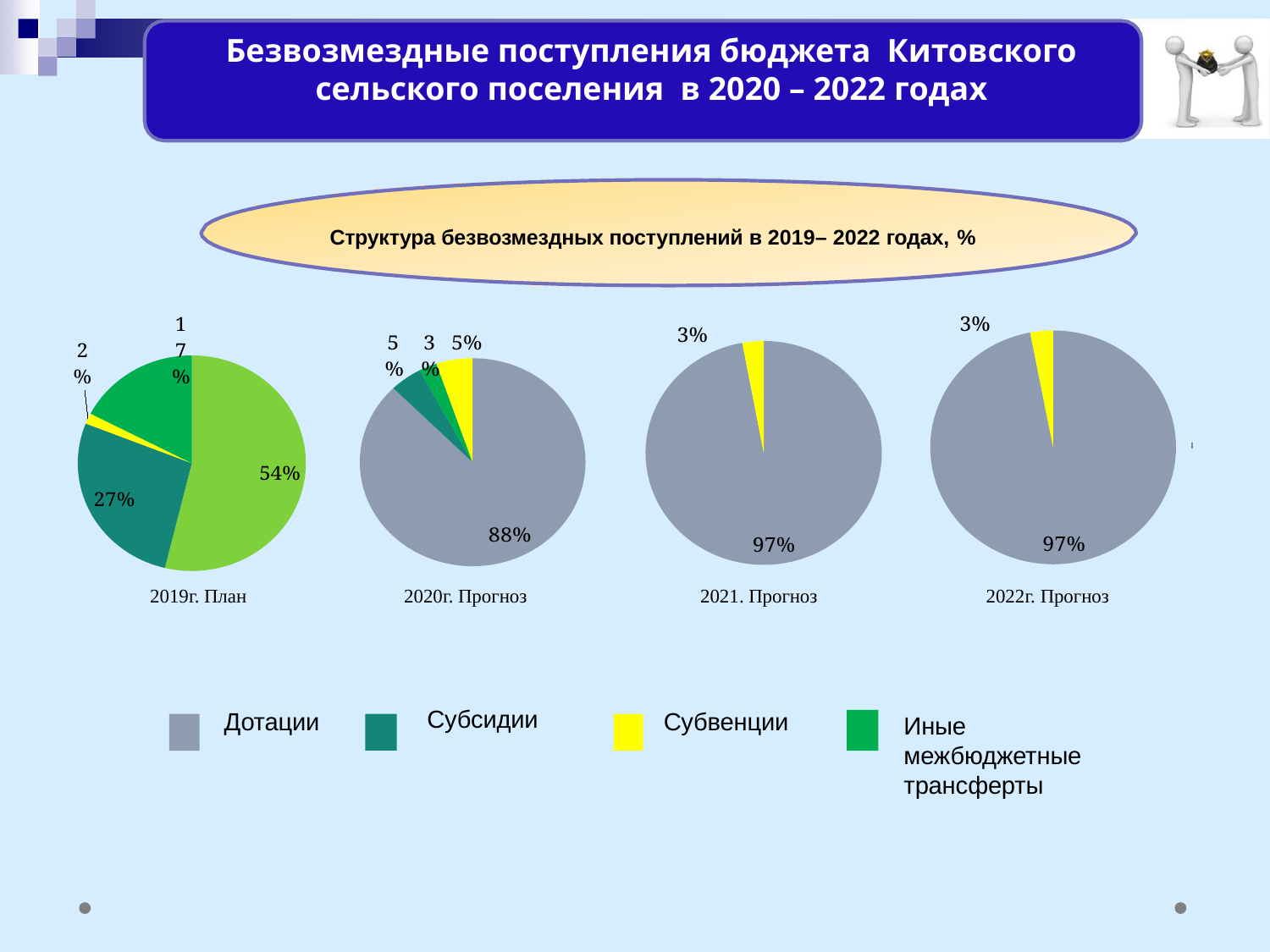
In the 2019г. План pie chart, what is the value of the largest slice? 54% How many pie charts are shown on the slide? 4 In the 2019г. План pie chart, what share is Иные межбюджетные трансферты? 17% What kind of charts are shown on the slide? Pie charts In the 2020г. Прогноз pie chart, what share is Дотации? 88% What colour does the legend use for Субвенции? Yellow In the 2019г. План pie chart, what share is Субсидии? 27% Is the Дотации share larger in the 2020г. Прогноз pie chart or in the 2021. Прогноз pie chart? 2021. Прогноз In the 2022г. Прогноз pie chart, what share is Субвенции? 3% How many categories does the legend list? 4 In the 2019г. План pie chart, what is the difference between the largest slice (54%) and the Субсидии slice (27%)? 27 percentage points In the 2021. Прогноз pie chart, what share is Дотации? 97%